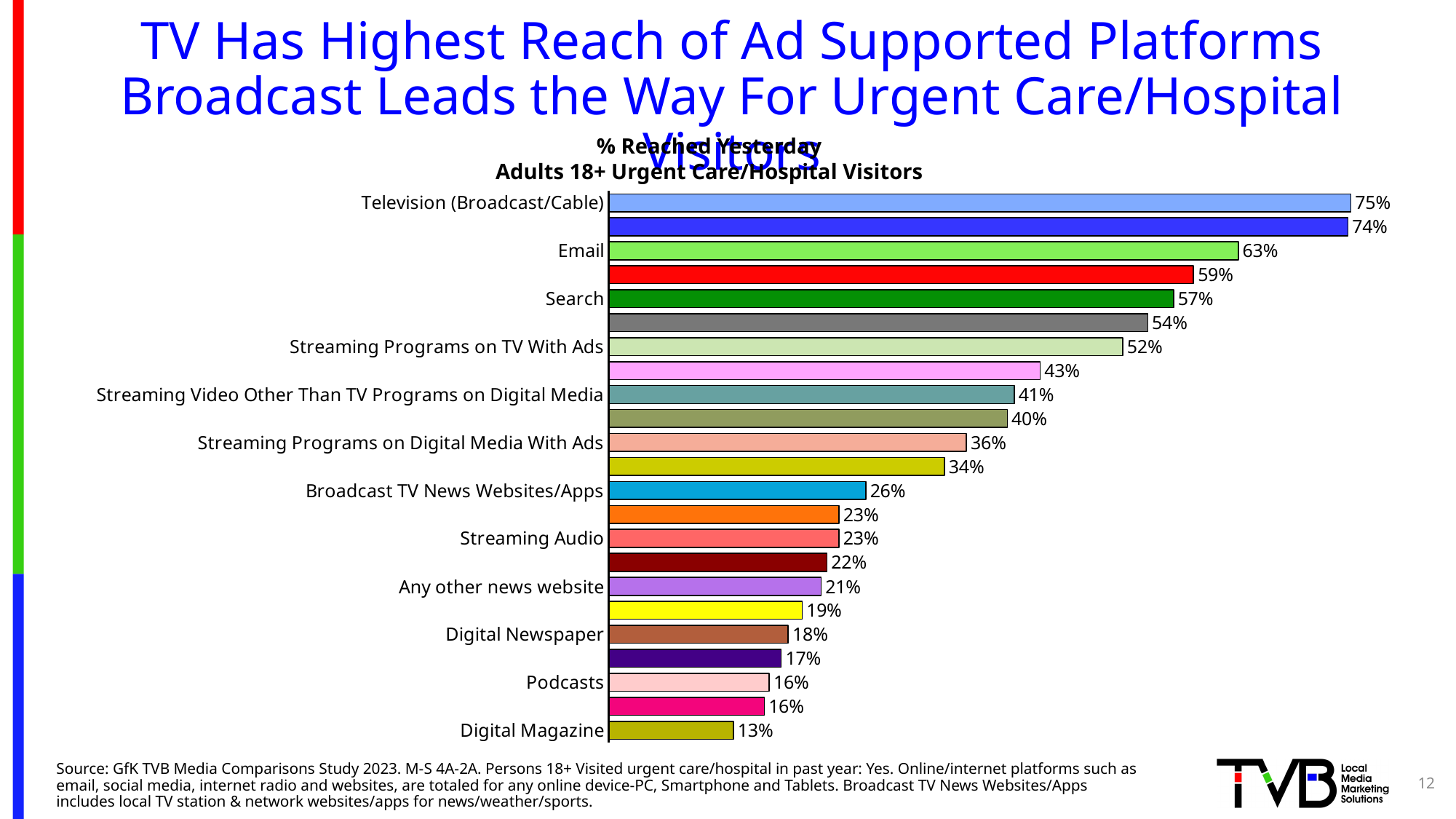
What is the value for Email? 63% What is the value for Streaming Programs on TV With Ads? 52% What is the difference between the values for Email and Search? 6% What is the difference between the values for Podcasts and Digital Magazine? 3% How many bars are plotted in the chart? 23 Which labeled category has the highest value? Television (Broadcast/Cable) What is the value for Digital Magazine? 13% Which is larger, the value for Streaming Audio or the value for Digital Newspaper? Streaming Audio What is the value for Television (Broadcast/Cable)? 75% What is the value for Broadcast TV News Websites/Apps? 26% What kind of chart is shown on the slide? Bar chart Which labeled category has the lowest value? Digital Magazine